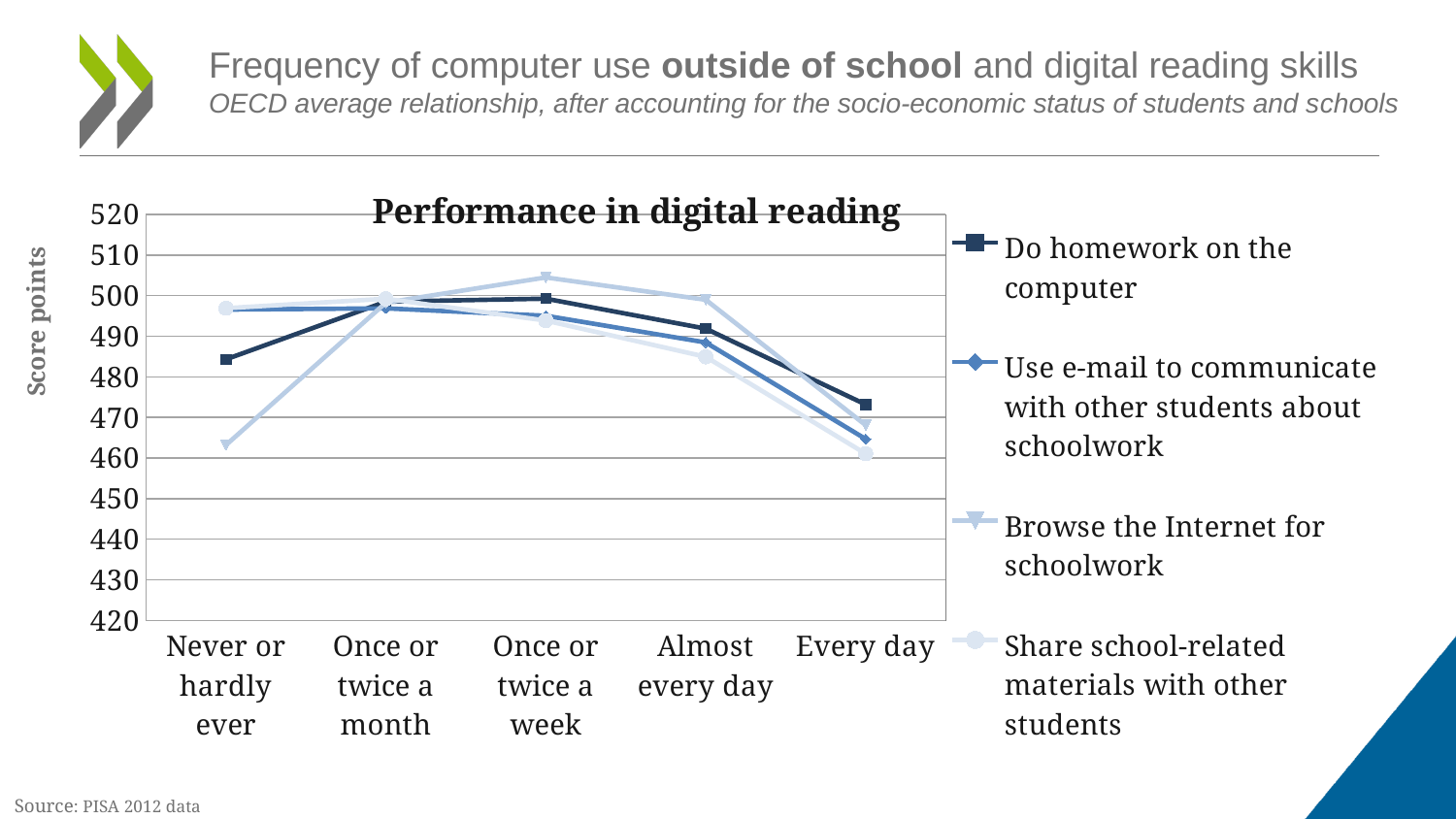
Is the value for 'Browse the Internet for schoolwork' at 'Once or twice a week' greater or less than 500? greater Which series has the lowest value at 'Never or hardly ever'? Browse the Internet for schoolwork How many frequency categories are shown on the x axis? 5 How many series does the legend list? 4 What is the label of the vertical axis? Score points Is the value for 'Share school-related materials with other students' at 'Every day' greater or less than 470? less At 'Never or hardly ever', which is larger: 'Do homework on the computer' or 'Browse the Internet for schoolwork'? Do homework on the computer What kind of chart is shown on the slide? Line chart Is the value for 'Do homework on the computer' at 'Never or hardly ever' greater or less than 480? greater What is the title of the chart? Performance in digital reading Do the values for 'Do homework on the computer' rise or fall from 'Once or twice a week' to 'Every day'? Fall